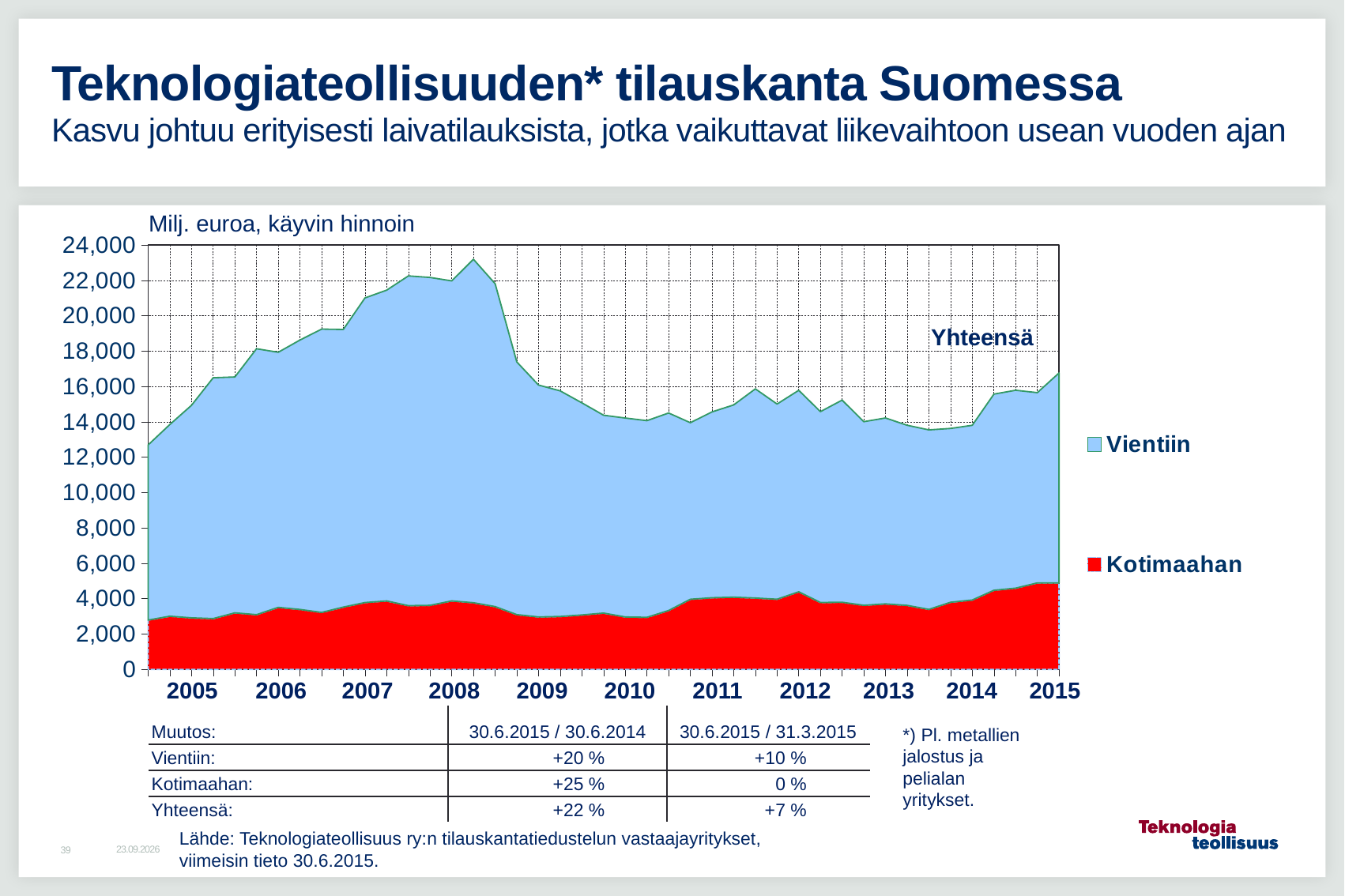
Is the total (Yhteensä) value in 2013 greater or less than 16,000? less Is the total (Yhteensä) value at the end of the series in 2015 greater or less than 14,000? greater How many year labels are shown on the x axis of the chart? 11 Which series is larger in 2015, Vientiin or Kotimaahan? Vientiin Is the Kotimaahan value in 2015 greater or less than 6,000? less Does the total (Yhteensä) order book rise or fall between 2008 and 2009? fall What are the two series named in the chart legend? Vientiin and Kotimaahan How many series does the chart legend list? 2 In which year does the total (Yhteensä) order book reach its highest level? 2008 What kind of chart is shown on the slide? Stacked area chart What unit label is shown above the chart's y axis? Milj. euroa, käyvin hinnoin